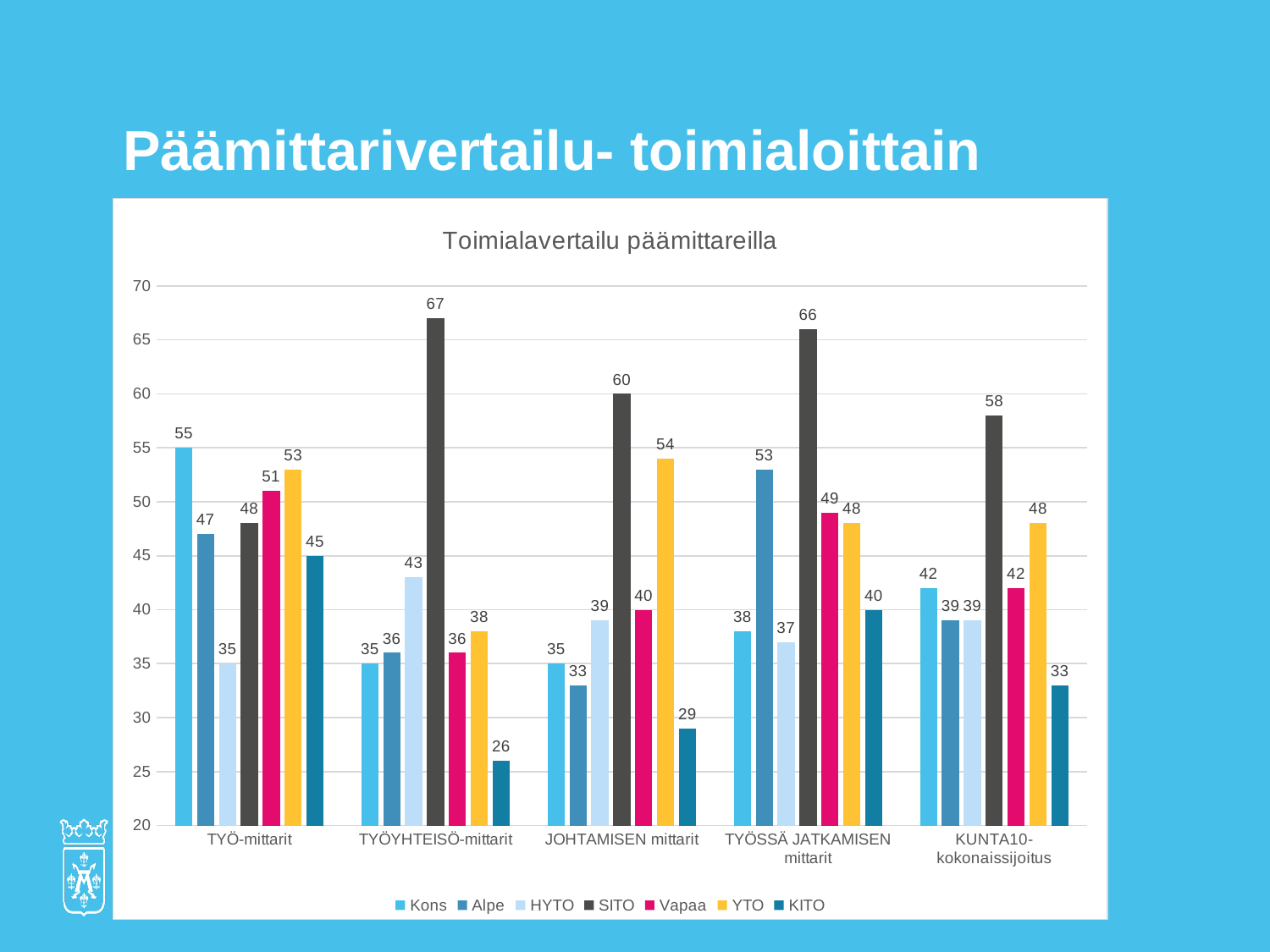
How many series does the legend list? 7 What is the difference between the SITO and Kons values in the JOHTAMISEN mittarit category? 25 What is the value for YTO in the KUNTA10-kokonaissijoitus category? 48 What is the value for KITO in the JOHTAMISEN mittarit category? 29 In the TYÖ-mittarit category, which is larger: the value for Vapaa or the value for Alpe? Vapaa Which series has the highest value in the TYÖSSÄ JATKAMISEN mittarit category? SITO What is the value for SITO in the TYÖYHTEISÖ-mittarit category? 67 Which series has the lowest value in the TYÖYHTEISÖ-mittarit category? KITO How many categories are shown on the x axis? 5 What is the title of the chart? Toimialavertailu päämittareilla What is the value for Kons in the TYÖ-mittarit category? 55 What kind of chart is shown on the slide? Bar chart